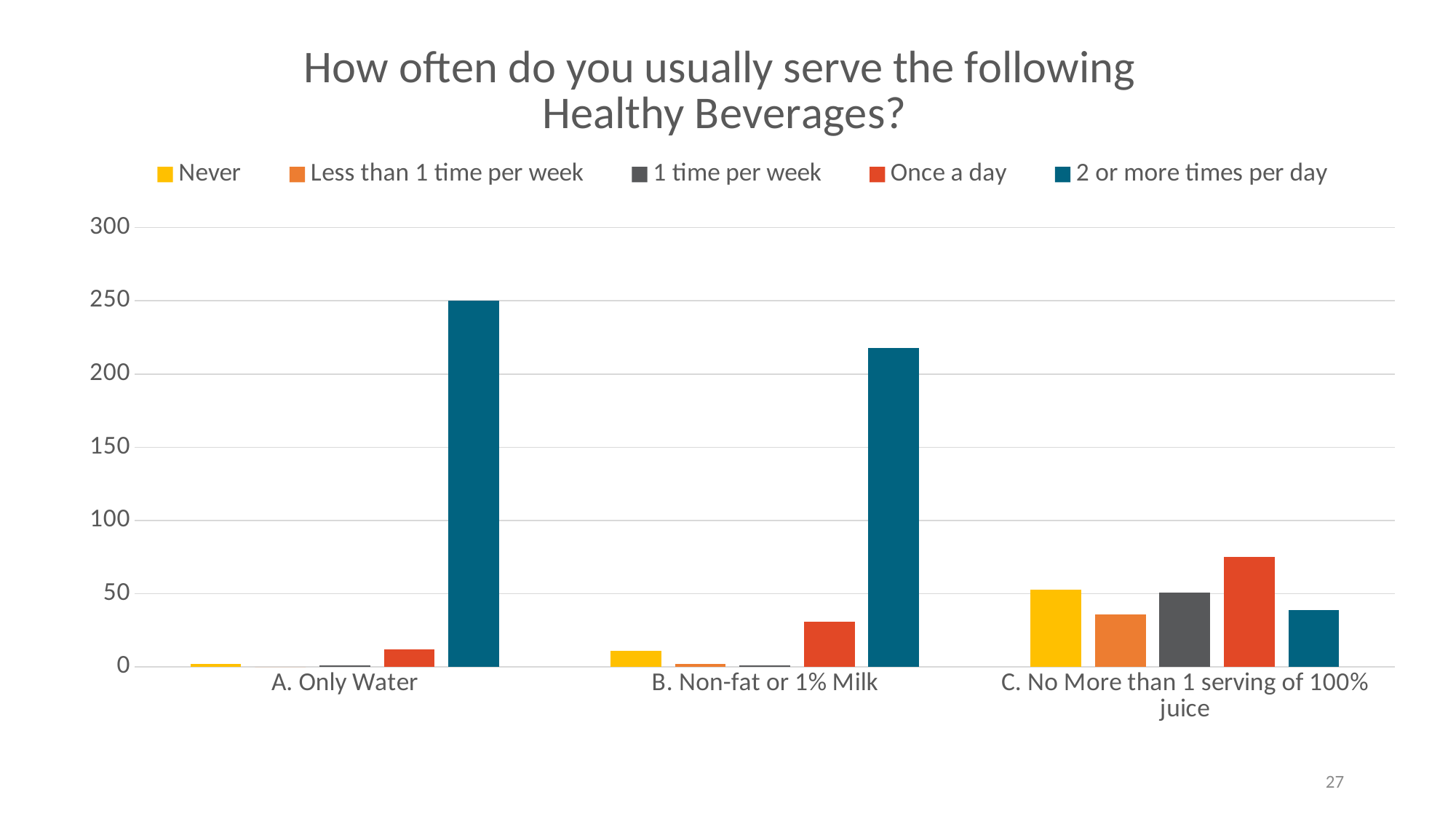
Which is larger: the Never value for C. No More than 1 serving of 100% juice or for B. Non-fat or 1% Milk? C. No More than 1 serving of 100% juice How many beverage categories are shown on the x axis? 3 Is the value for 2 or more times per day for B. Non-fat or 1% Milk greater or less than 200? greater For A. Only Water, which response has the highest value? 2 or more times per day Which is larger: the 2 or more times per day value for A. Only Water or for B. Non-fat or 1% Milk? A. Only Water What kind of chart is shown on the slide? bar chart Is the value for Once a day for B. Non-fat or 1% Milk greater or less than 50? less What is the title of the chart? How often do you usually serve the following Healthy Beverages? How many series does the legend list? 5 For C. No More than 1 serving of 100% juice, which response has the highest value? Once a day Is the value for Once a day for C. No More than 1 serving of 100% juice greater or less than 50? greater Which legend entry is shown in yellow? Never